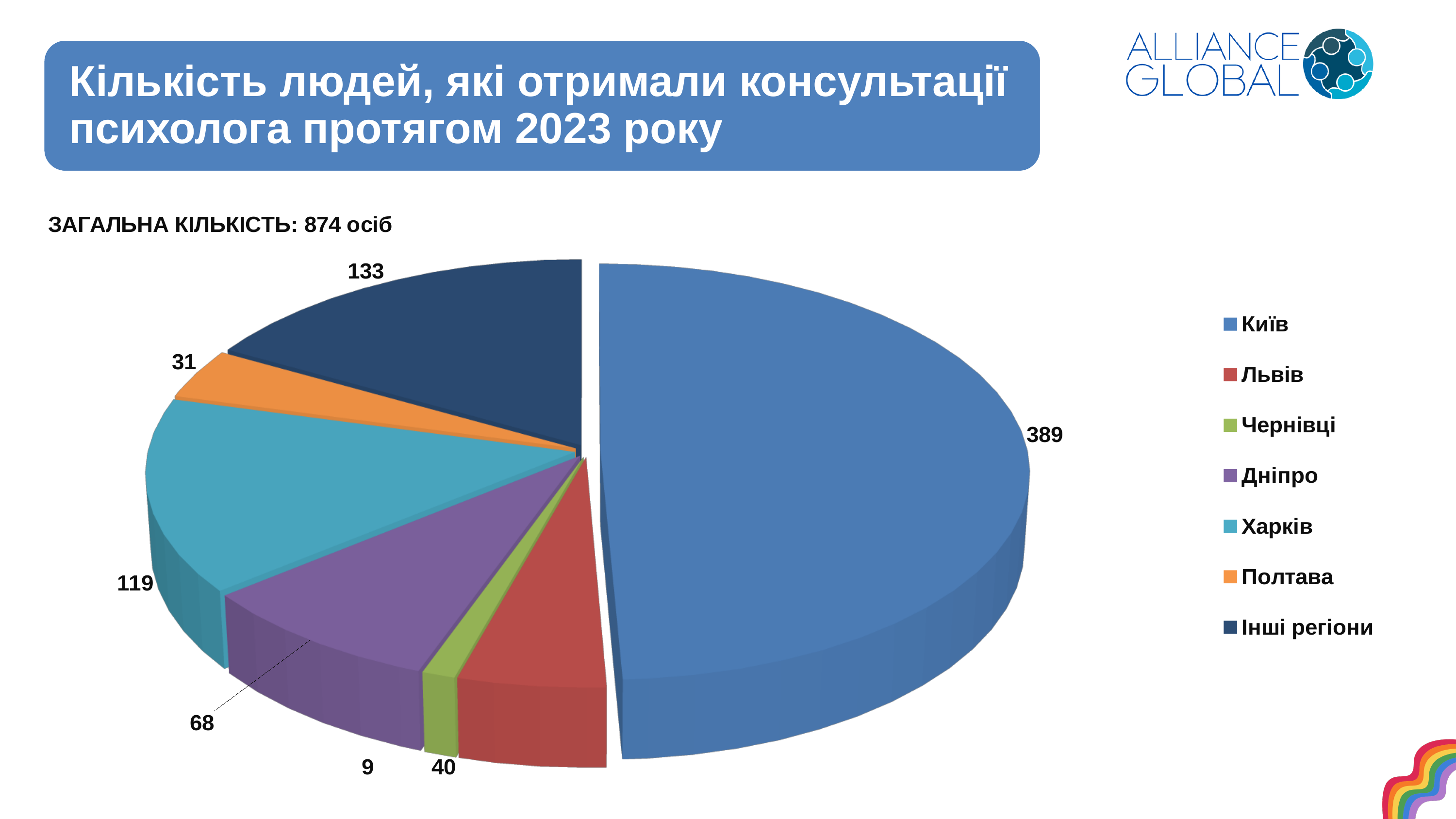
What total number of people is stated above the chart? 874 осіб What is the value shown for Харків? 119 How many people received psychologist consultations in Київ according to the chart? 389 What is the value shown for Полтава? 31 What is the difference between the values for Львів and Чернівці? 31 What kind of chart is shown on the slide? pie chart Which category has the largest slice of the pie? Київ What is the value shown for Дніпро? 68 How many categories does the legend list? 7 What is the value shown for Інші регіони? 133 Which category has the smallest slice of the pie? Чернівці Which is larger, the value for Харків or the value for Інші регіони? Інші регіони